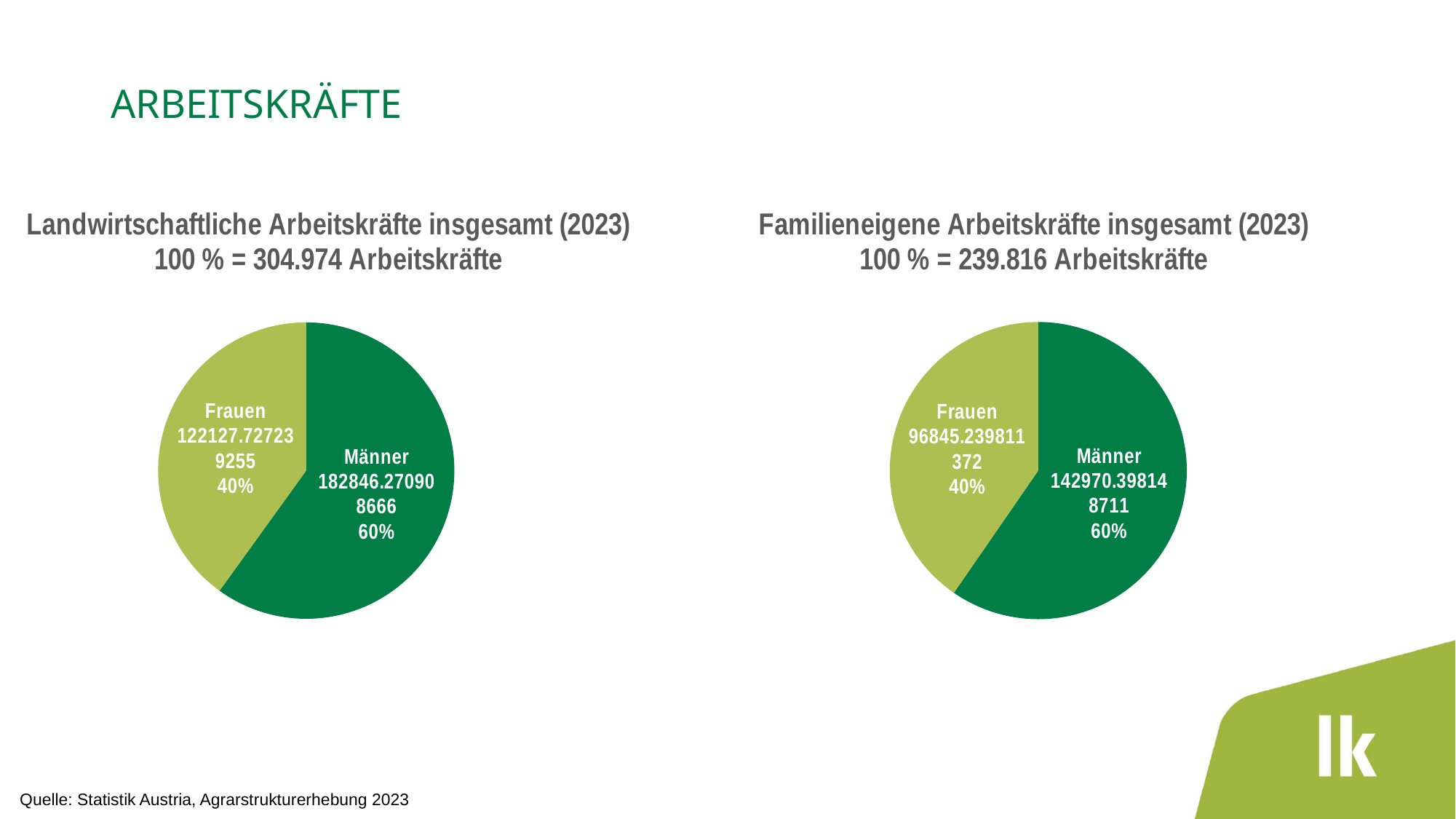
According to the title of the left chart, how many Arbeitskräfte correspond to 100 %? 304.974 Arbeitskräfte In the 'Landwirtschaftliche Arbeitskräfte insgesamt (2023)' chart, what is the difference in percentage points between the Männer share and the Frauen share? 20 percentage points In the 'Landwirtschaftliche Arbeitskräfte insgesamt (2023)' chart, what percentage share is shown for Männer? 60% In the 'Landwirtschaftliche Arbeitskräfte insgesamt (2023)' chart, which slice is larger, Frauen or Männer? Männer In the 'Familieneigene Arbeitskräfte insgesamt (2023)' chart, what percentage share is shown for Frauen? 40% How many slices does the 'Familieneigene Arbeitskräfte insgesamt (2023)' pie chart have? 2 What kind of chart is the 'Landwirtschaftliche Arbeitskräfte insgesamt (2023)' chart? pie chart In the 'Familieneigene Arbeitskräfte insgesamt (2023)' chart, which slice is the smallest? Frauen In the 'Landwirtschaftliche Arbeitskräfte insgesamt (2023)' chart, which slice is the largest? Männer In the 'Familieneigene Arbeitskräfte insgesamt (2023)' chart, what percentage share is shown for Männer? 60% According to the title of the right chart, how many Arbeitskräfte correspond to 100 %? 239.816 Arbeitskräfte